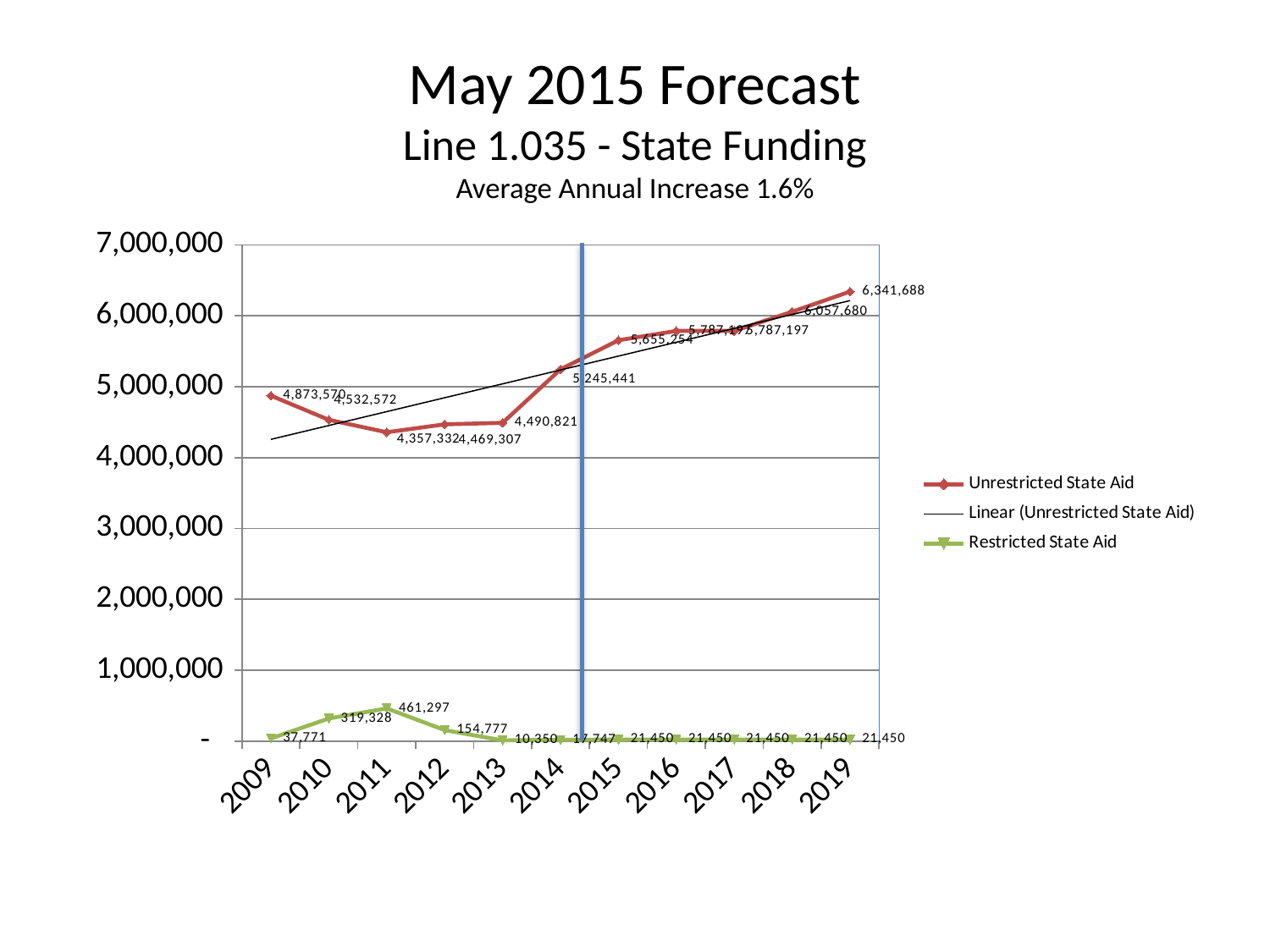
In which year is Unrestricted State Aid lowest? 2011 In which year is Restricted State Aid highest? 2011 What is the Restricted State Aid value for 2009? 37,771 Is the Unrestricted State Aid value for 2014 greater or less than 5,000,000? greater How many years are shown on the x axis of the chart? 11 What is the difference between Unrestricted State Aid in 2019 and in 2018? 284,008 What kind of chart is shown on the slide? Line chart What average annual increase is stated in the chart's subtitle? 1.6% What is the Unrestricted State Aid value for 2019? 6,341,688 In which year is Unrestricted State Aid highest? 2019 What is the Restricted State Aid value for 2011? 461,297 How many series does the chart's legend list? 3